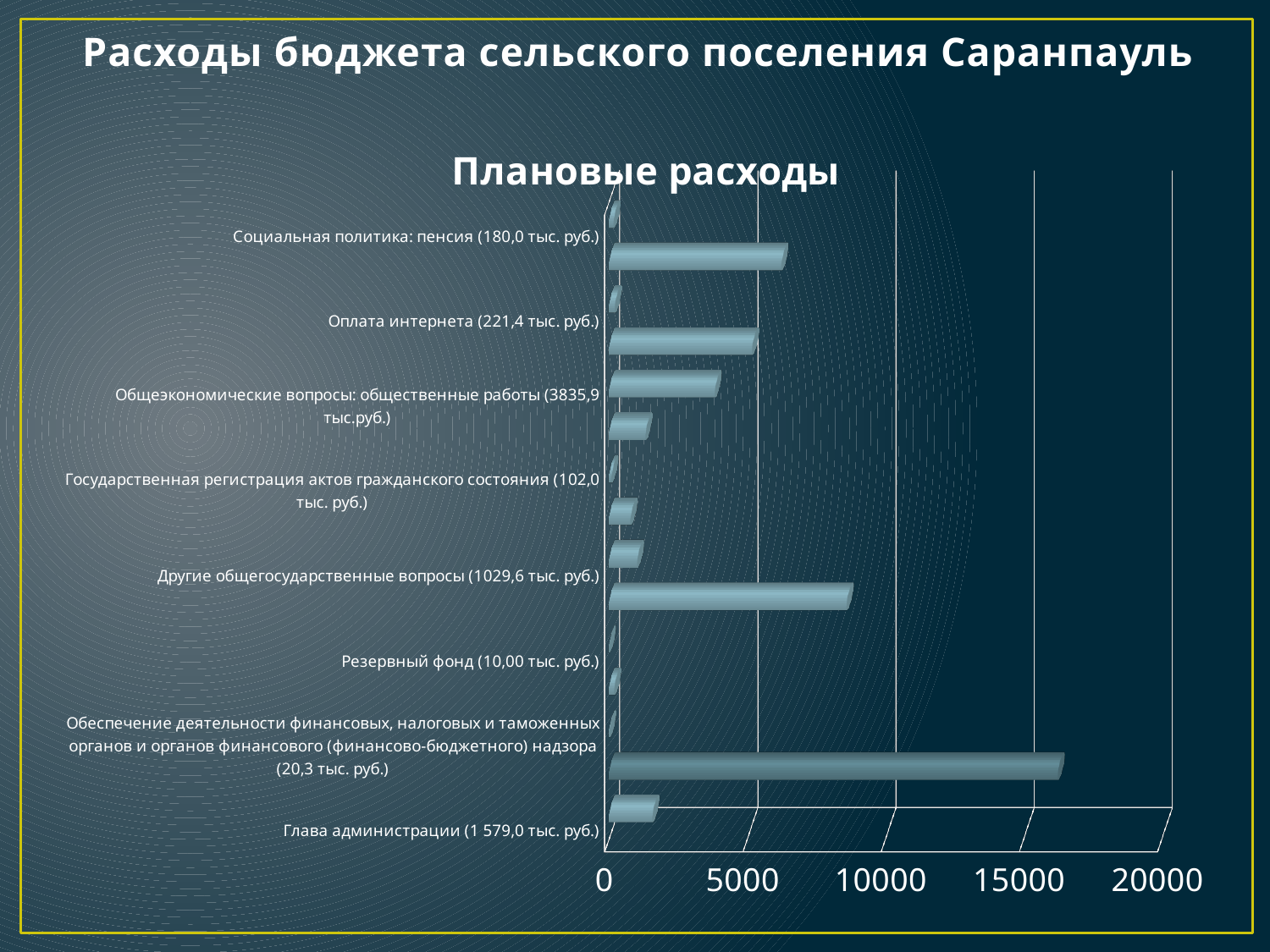
What is the highest value shown on the horizontal axis of the chart? 20000 What is the title of the chart on the slide? Плановые расходы What kind of chart is shown on the slide? bar chart Is the longest bar in the chart greater or less than 10000? greater Is the longest bar in the chart greater or less than 15000? greater How many category labels are listed on the vertical axis of the chart? 8 Does any bar in the chart reach the 20000 mark on the horizontal axis? No